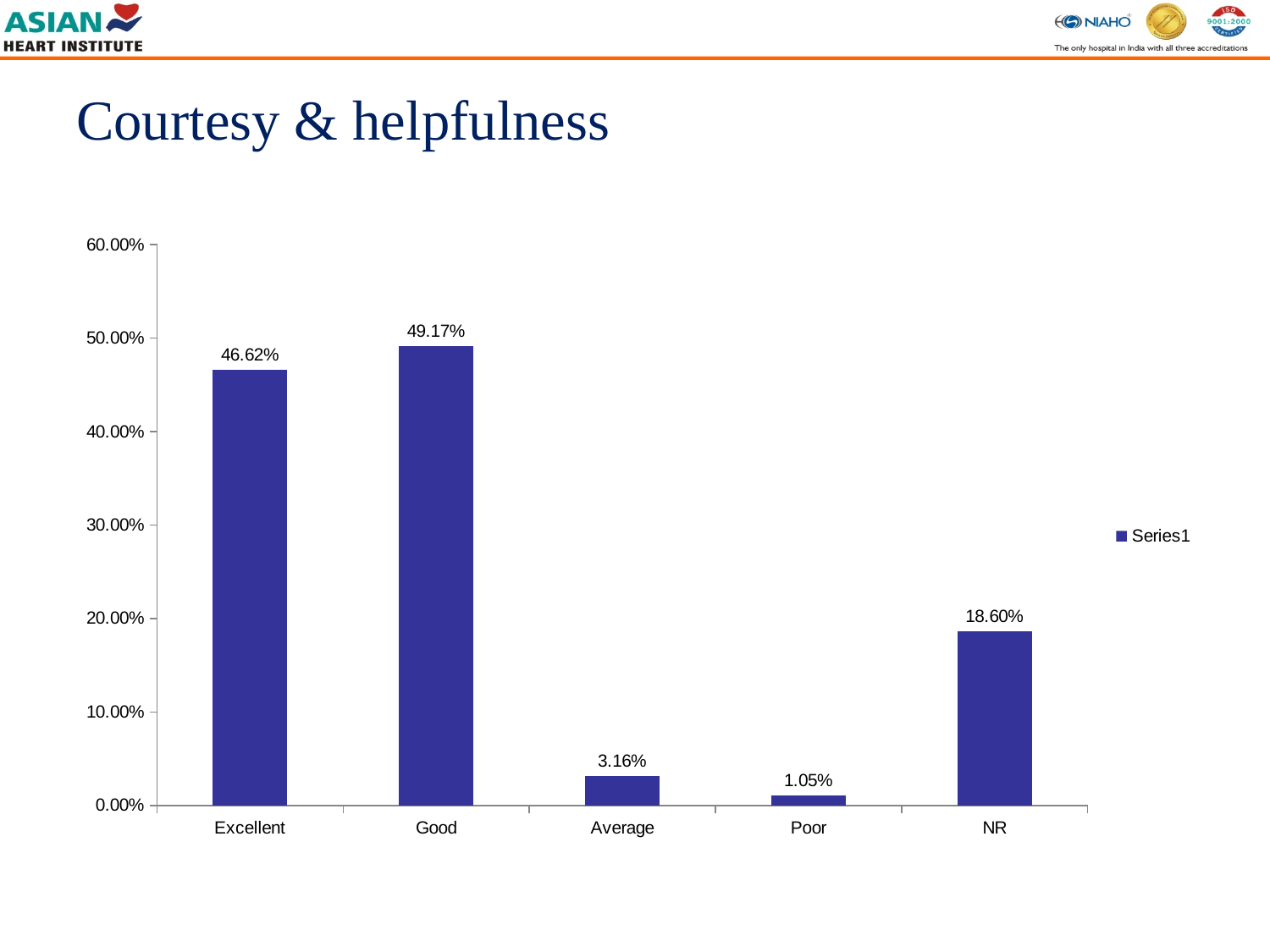
What is the value for Excellent? 46.62% What is the title of the slide containing the chart? Courtesy & helpfulness What is the value for Good? 49.17% Which category has the lowest value? Poor What is the value for NR? 18.60% What is the difference between the values for Good and Excellent? 2.55% What is the value for Average? 3.16% What is the value for Poor? 1.05% How many categories are shown on the x axis? 5 What kind of chart is shown on the slide? Bar chart Which is larger, the value for NR or the value for Average? NR Which category has the highest value? Good